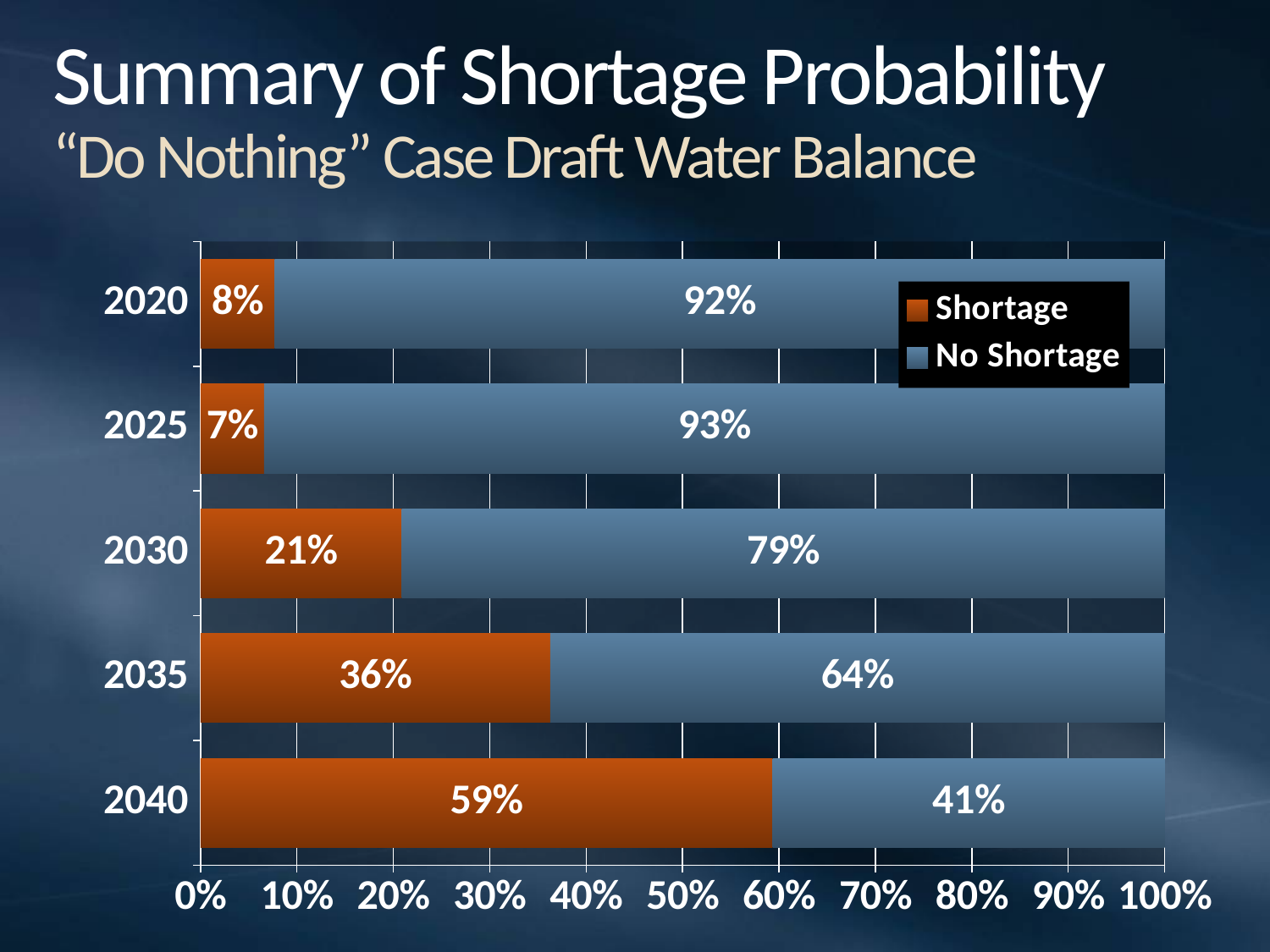
What is the Shortage value for 2040? 59% Which is larger, the No Shortage value for 2020 or for 2030? 2020 How many series does the legend list? 2 Which year has the highest Shortage probability? 2040 Does the Shortage probability rise or fall from 2025 to 2040? Rise What is the Shortage probability for 2030? 21% What is the No Shortage value for 2035? 64% What is the difference between the Shortage values for 2040 and 2035? 23% Which year has the lowest Shortage probability? 2025 How many years are shown on the chart? 5 What kind of chart is shown on the slide? Bar chart What colour represents the Shortage series in the legend? Orange